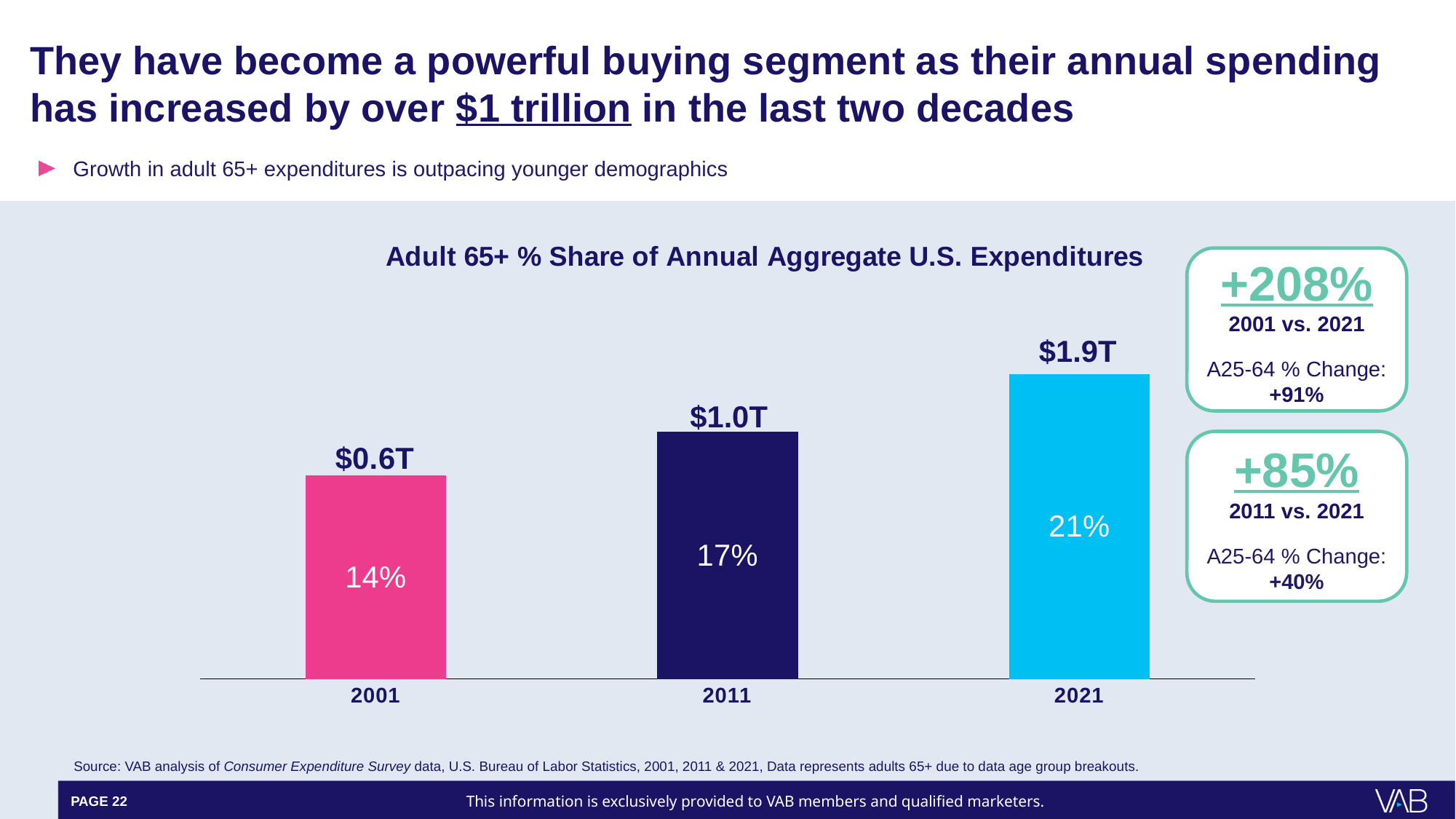
How many years are plotted in the chart? 3 What percentage share is shown inside the bar for 2021? 21% What dollar value is labelled above the 2001 bar? $0.6T What is the title of the chart? Adult 65+ % Share of Annual Aggregate U.S. Expenditures What is the difference in percentage share between 2021 and 2001? 7 percentage points Which year has the lowest bar in the chart? 2001 What percentage share is shown inside the bar for 2001? 14% What percentage share is shown inside the bar for 2011? 17% What kind of chart is shown on the slide? bar chart Which year has the highest bar in the chart? 2021 What dollar value is labelled above the 2021 bar? $1.9T Do the bar values rise or fall from 2001 to 2021? rise